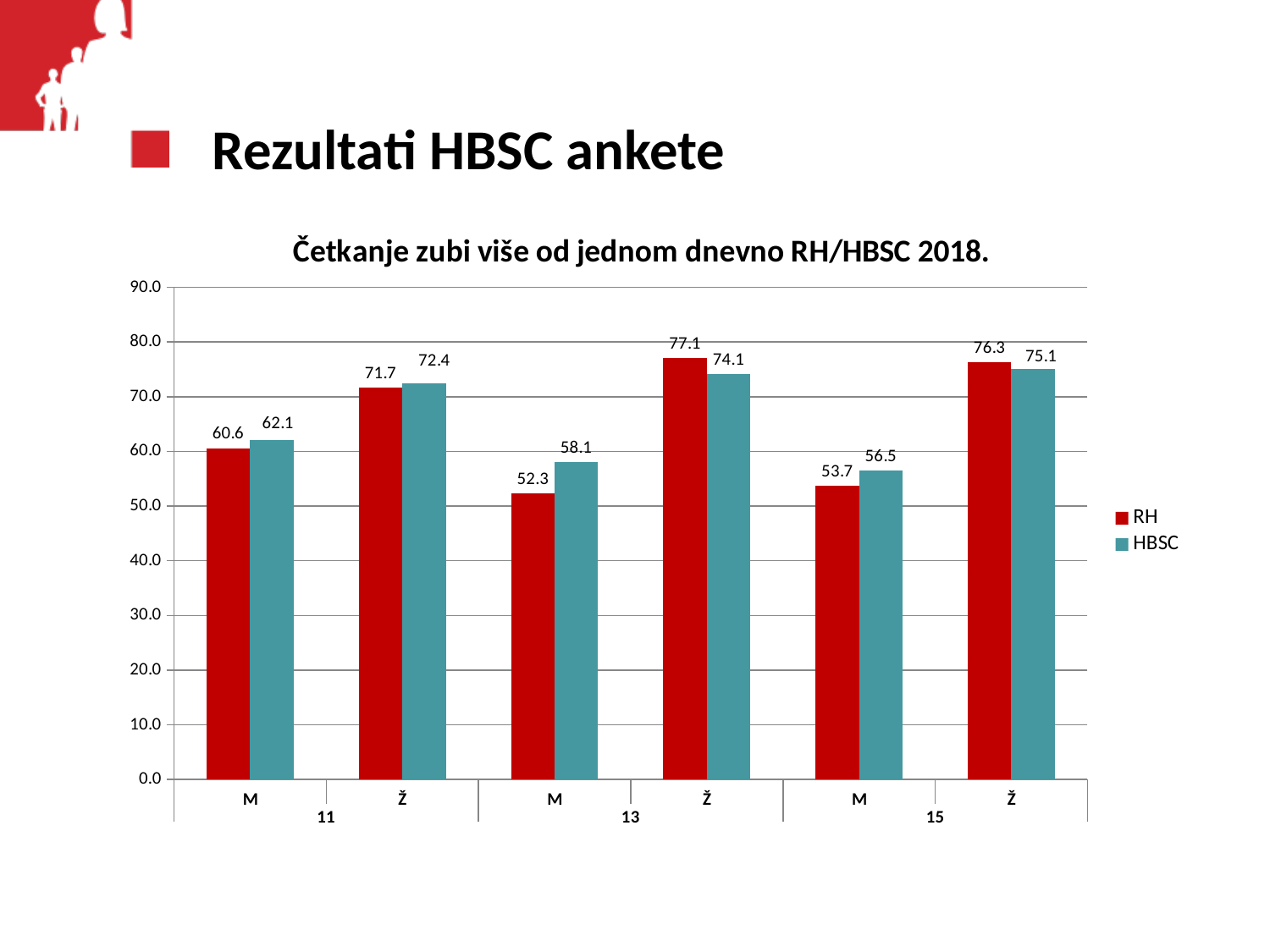
What is the RH value for M in the 15 age group? 53.7 Is the RH value for M in the 13 age group greater or less than 60.0? less What is the RH value for M in the 11 age group? 60.6 Which category has the lowest HBSC value? M, 15 What is the HBSC value for Ž in the 13 age group? 74.1 What kind of chart is shown on the slide? bar chart What is the title of the chart? Četkanje zubi više od jednom dnevno RH/HBSC 2018. Which is larger for Ž in the 15 age group, the RH value or the HBSC value? RH How many series does the legend list? 2 What is the difference between the HBSC and RH values for M in the 13 age group? 5.8 How many categories are shown on the x axis? 6 Which category has the highest RH value? Ž, 13